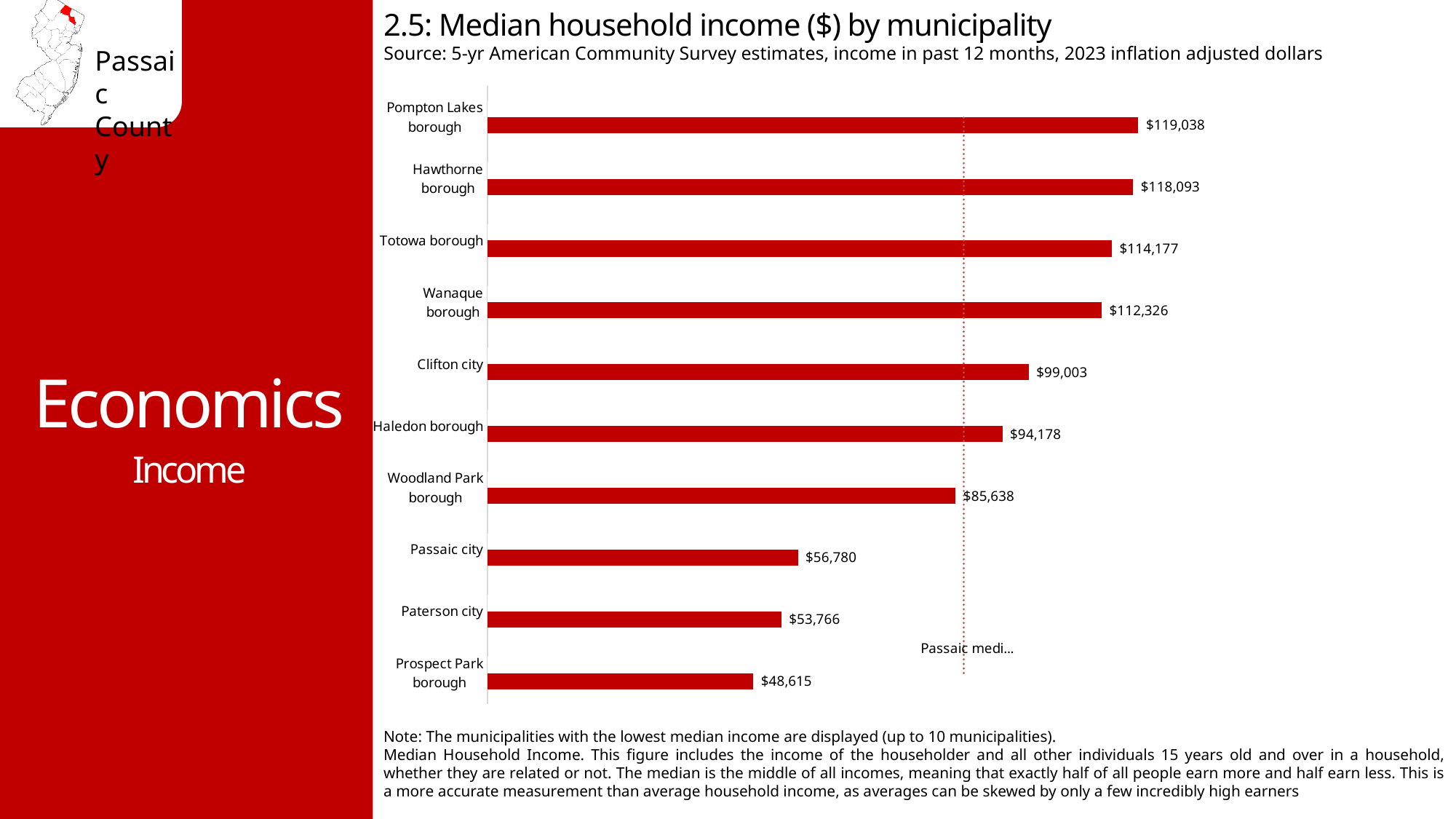
What is the median household income for Paterson city? $53,766 What is the difference in median household income between Pompton Lakes borough and Hawthorne borough? $945 What is the median household income for Clifton city? $99,003 Which municipality has the highest median household income on the chart? Pompton Lakes borough What is the difference in median household income between Passaic city and Paterson city? $3,014 How many municipalities are shown on the chart? 10 What is the title of the chart? 2.5: Median household income ($) by municipality Which has a higher median household income, Totowa borough or Clifton city? Totowa borough What is the median household income for Wanaque borough? $112,326 Which municipality has the lowest median household income on the chart? Prospect Park borough Which has a higher median household income, Haledon borough or Woodland Park borough? Haledon borough What kind of chart is used to show median household income by municipality? Bar chart